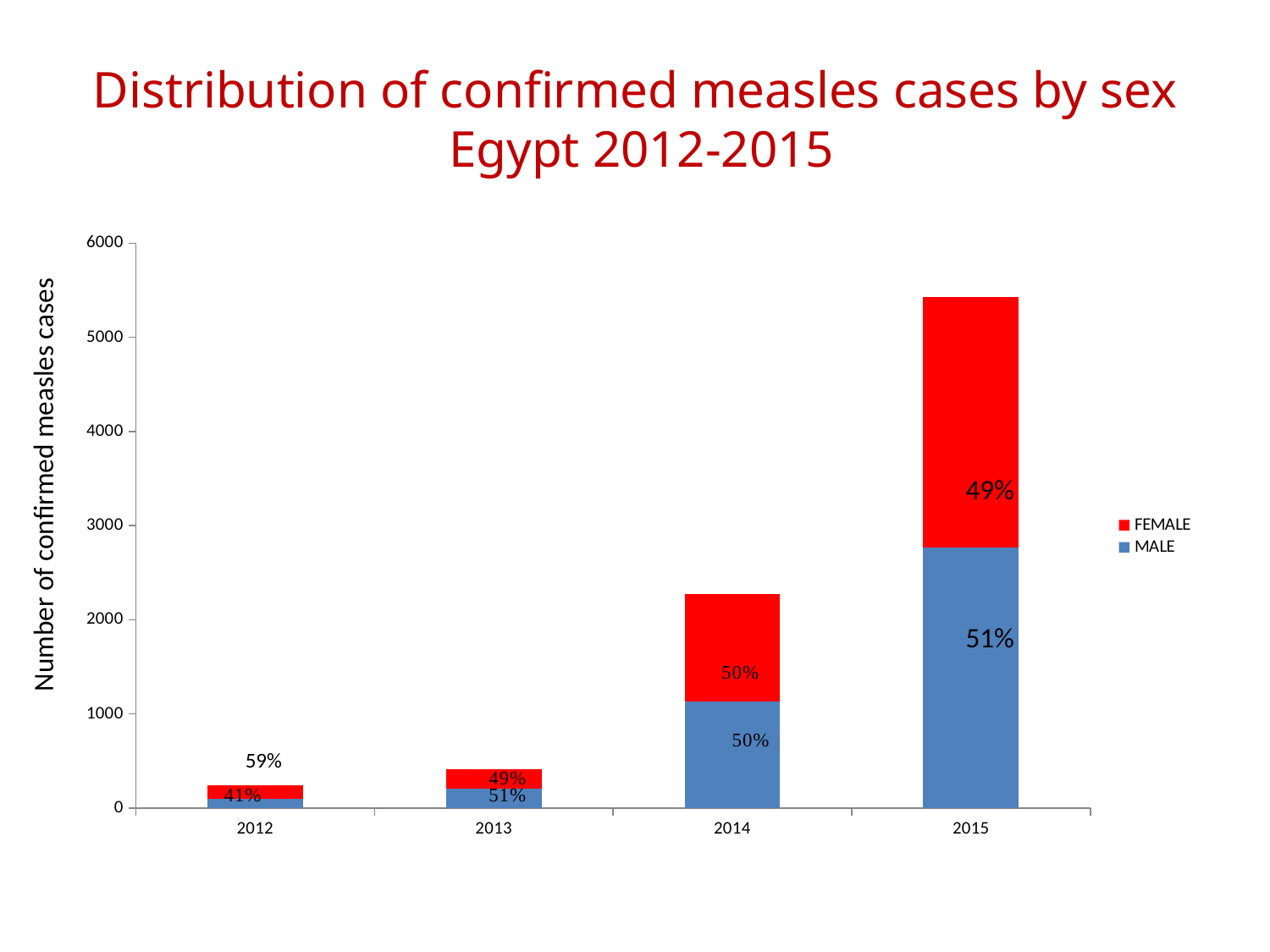
How many years are shown on the x axis? 4 Is the total number of confirmed measles cases in 2013 greater or less than 1000? less What percentage label is shown for the FEMALE segment in 2014? 50% What percentage label is shown for the MALE segment in 2015? 51% Is the total number of confirmed measles cases in 2015 greater or less than 5000? greater How many series does the legend list? 2 What percentage label is shown for the FEMALE segment in 2012? 59% Which year has a larger total of confirmed measles cases, 2014 or 2015? 2015 Do the total confirmed measles cases rise or fall from 2012 to 2015? rise What percentage label is shown for the MALE segment in 2012? 41% Which year has the highest total number of confirmed measles cases? 2015 Which year has the lowest total number of confirmed measles cases? 2012